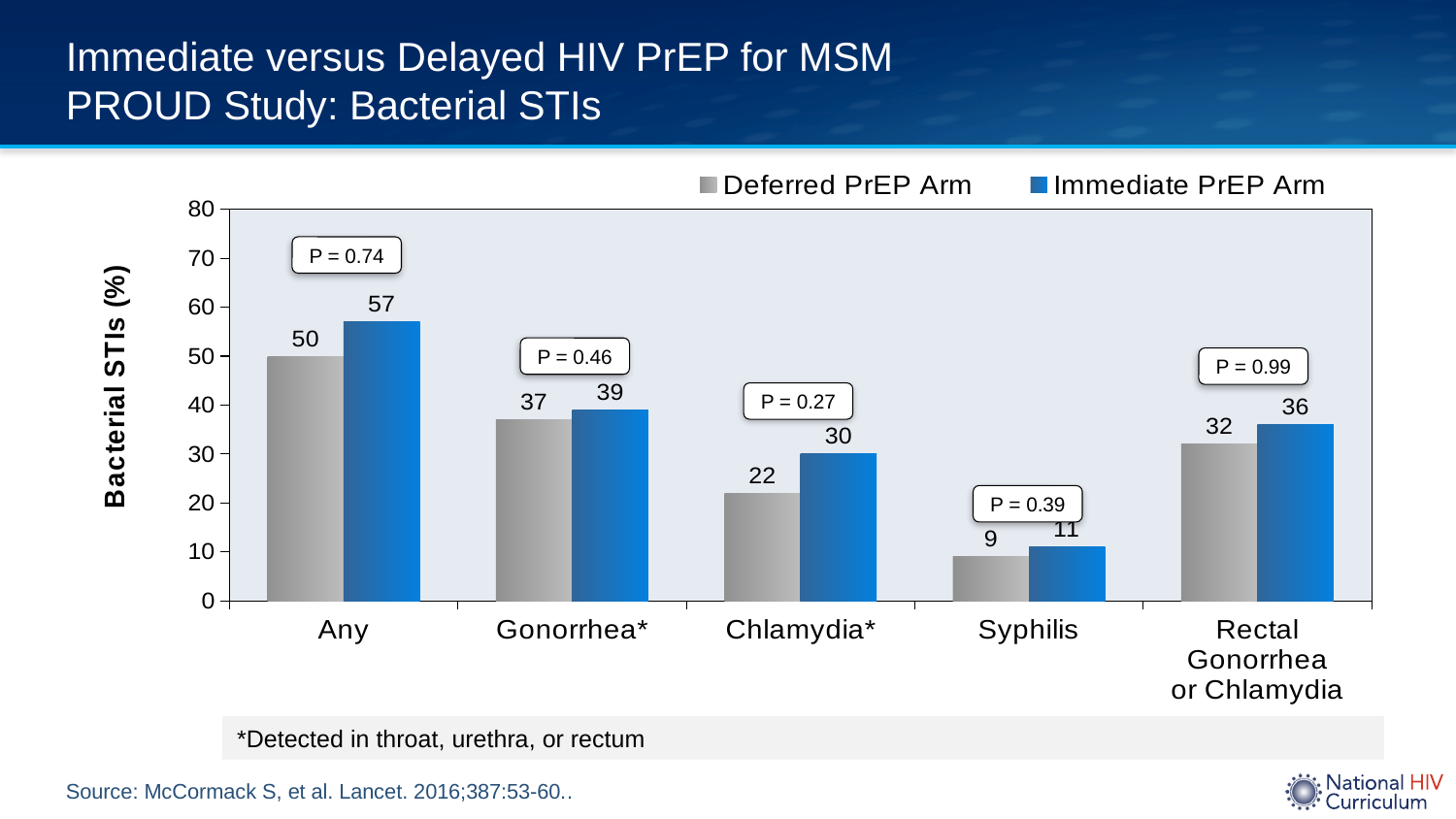
What is the difference between the Immediate PrEP Arm and Deferred PrEP Arm values for Chlamydia*? 8 How many categories are shown on the x axis? 5 Which category has the highest value for the Immediate PrEP Arm? Any What P value is shown above the Gonorrhea* bars? P = 0.46 What is the value for the Deferred PrEP Arm for Syphilis? 9 What is the value for the Deferred PrEP Arm for Chlamydia*? 22 What kind of chart is shown on the slide? Bar chart Which category has the lowest value for the Deferred PrEP Arm? Syphilis How many series does the legend list? 2 What is the difference between the Immediate PrEP Arm and Deferred PrEP Arm values for Any? 7 What is the value for the Immediate PrEP Arm in the Any category? 57 For Rectal Gonorrhea or Chlamydia, which arm has the larger value? Immediate PrEP Arm